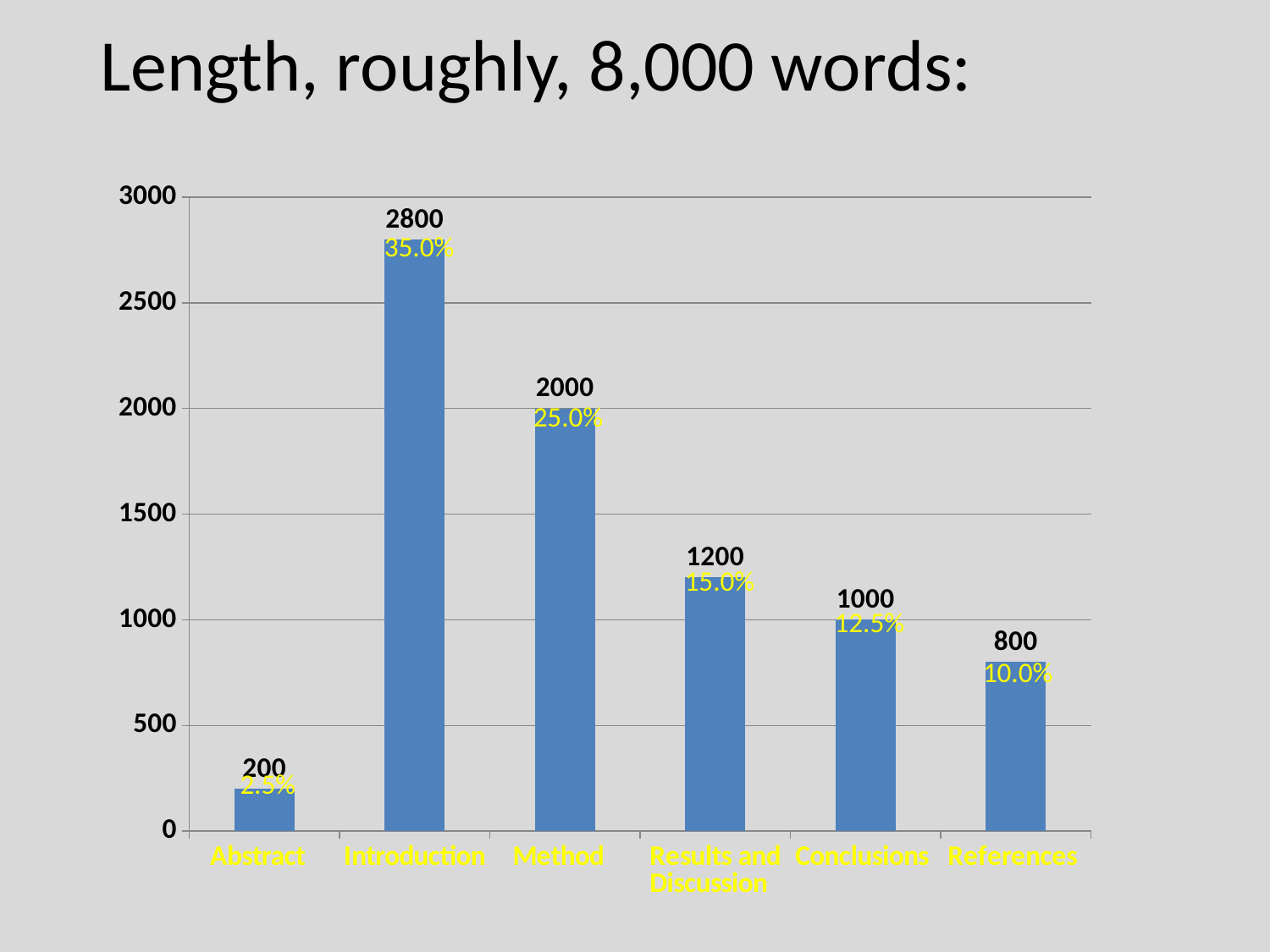
What is the difference between the values for Introduction and Method? 800 What percentage label is shown for Method? 25.0% What is the value for Results and Discussion? 1200 Which category has the highest value? Introduction What is the value for Abstract? 200 Which category has the lowest value? Abstract What is the value for Introduction? 2800 Which is larger, the value for Method or the value for Results and Discussion? Method How many categories are shown on the x axis? 6 What kind of chart is shown on the slide? Bar chart What is the title of the slide? Length, roughly, 8,000 words: What is the difference between the values for Conclusions and References? 200